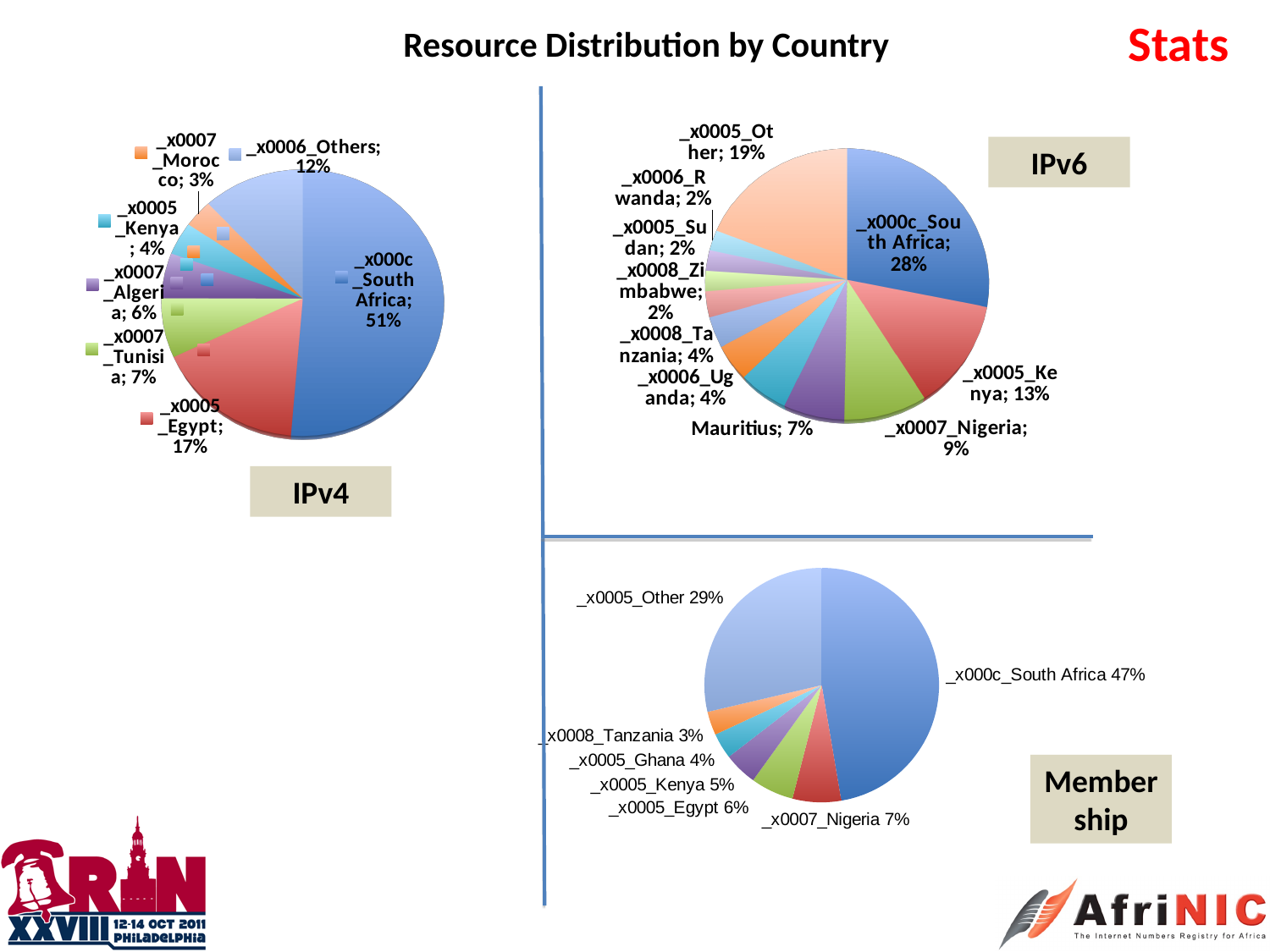
In the IPv6 pie chart, what is the difference between South Africa's share and Kenya's share? 15% In the IPv4 pie chart, what share does South Africa have? 51% In the IPv4 pie chart, which country has the largest share? South Africa In the IPv6 pie chart, what share does Mauritius have? 7% In the IPv4 pie chart, which is larger, Tunisia's share or Algeria's share? Tunisia In the Membership pie chart, what is the difference between Nigeria's share and Egypt's share? 1% How many slices does the IPv6 pie chart have? 12 In the Membership pie chart, which named country has the smallest share? Tanzania In the IPv6 pie chart, what share does Kenya have? 13% In the Membership pie chart, what share does South Africa have? 47% In the IPv4 pie chart, what share does Egypt have? 17% What type of chart is used for the Membership data? Pie chart